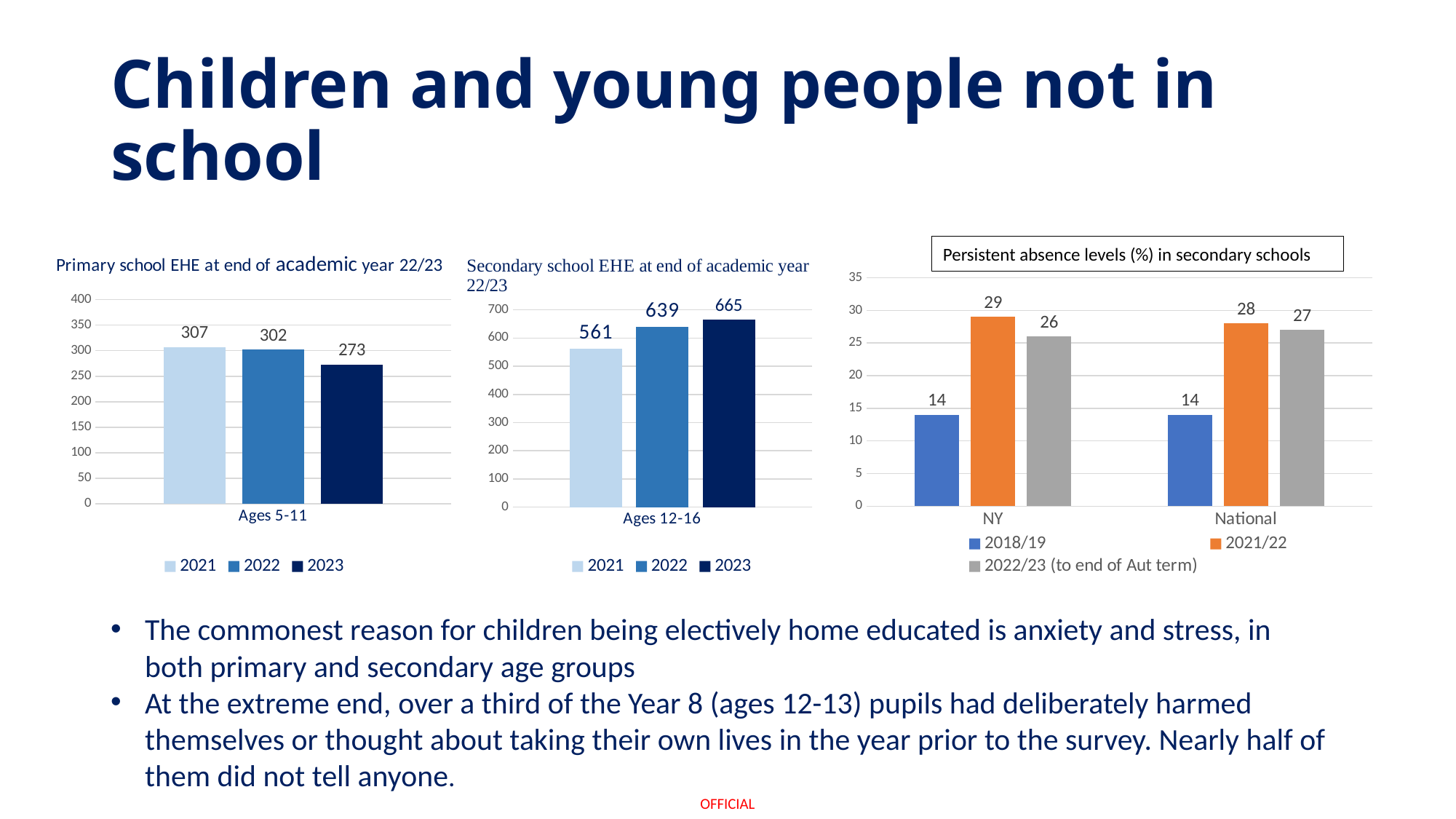
In the 'Secondary school EHE at end of academic year 22/23' chart, what is the value for 2022? 639 In the 'Persistent absence levels (%) in secondary schools' chart, which is larger for 2022/23 (to end of Aut term): NY or National? National What kind of chart is the 'Persistent absence levels (%) in secondary schools' chart? bar chart In the 'Primary school EHE at end of academic year 22/23' chart, do the values rise or fall from 2021 to 2023? fall In the 'Primary school EHE at end of academic year 22/23' chart, what is the difference between the 2021 and 2023 values? 34 In the 'Primary school EHE at end of academic year 22/23' chart, which year has the highest value? 2021 In the 'Secondary school EHE at end of academic year 22/23' chart, what is the difference between the 2023 and 2021 values? 104 In the 'Persistent absence levels (%) in secondary schools' chart, what is the value for NY in 2021/22? 29 In the 'Persistent absence levels (%) in secondary schools' chart, how many categories are shown on the x axis? 2 In the 'Secondary school EHE at end of academic year 22/23' chart, how many series does the legend list? 3 In the 'Primary school EHE at end of academic year 22/23' chart, what is the value for 2023? 273 In the 'Secondary school EHE at end of academic year 22/23' chart, which year has the lowest value? 2021